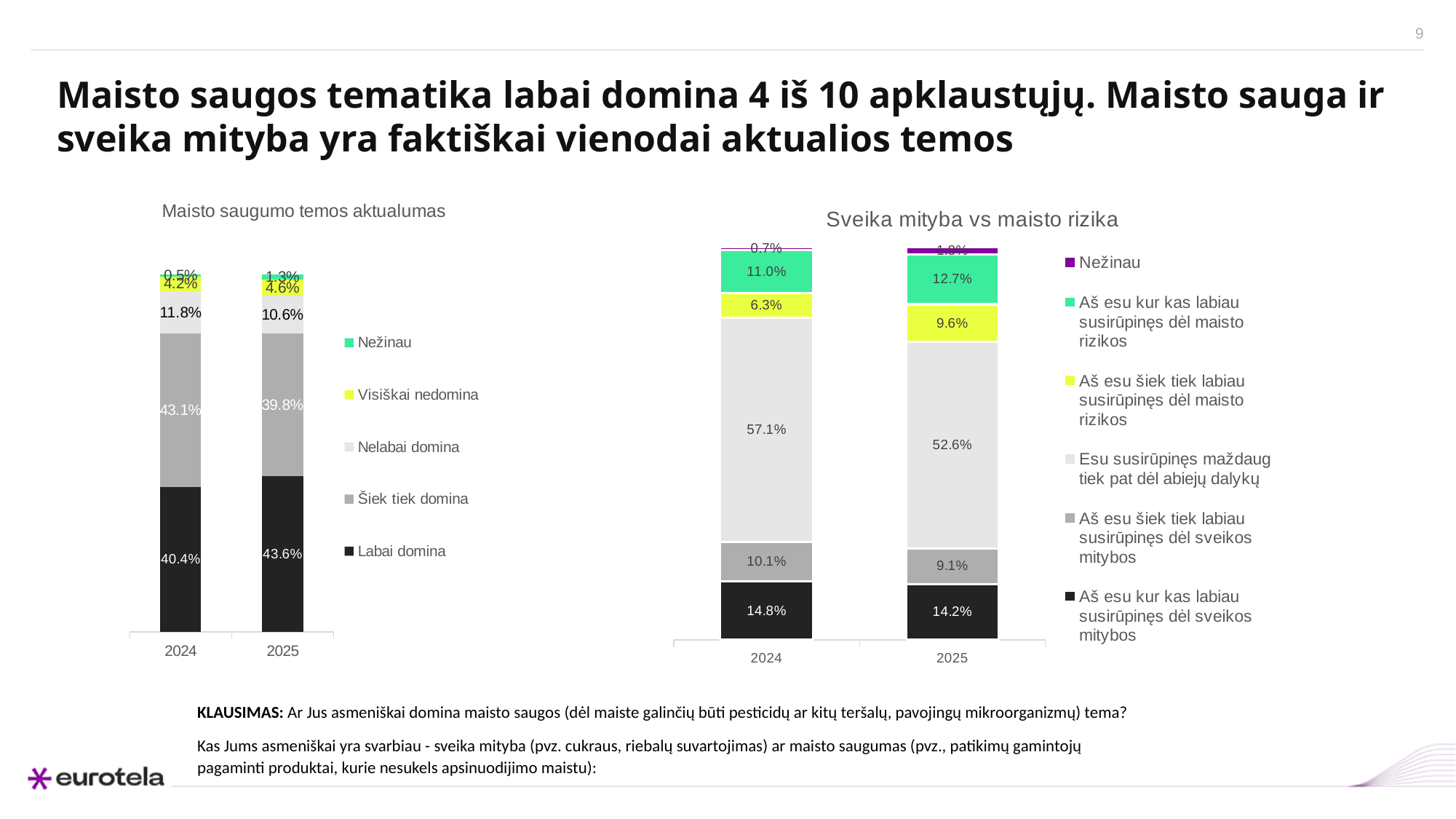
What kind of chart is the chart titled "Sveika mityba vs maisto rizika"? Stacked bar chart In the chart titled "Maisto saugumo temos aktualumas", how many series does the legend list? 5 In the chart titled "Sveika mityba vs maisto rizika", how many series does the legend list? 6 In the chart titled "Maisto saugumo temos aktualumas", what is the value for "Labai domina" in 2024? 40.4% In the chart titled "Maisto saugumo temos aktualumas", which is larger in 2024: "Labai domina" or "Šiek tiek domina"? Šiek tiek domina In the chart titled "Maisto saugumo temos aktualumas", what is the value for "Nelabai domina" in 2024? 11.8% In the chart titled "Sveika mityba vs maisto rizika", what is the value for "Aš esu kur kas labiau susirūpinęs dėl maisto rizikos" in 2025? 12.7% In the chart titled "Maisto saugumo temos aktualumas", what is the value for "Šiek tiek domina" in 2025? 39.8% In the chart titled "Sveika mityba vs maisto rizika", what is the value for "Aš esu kur kas labiau susirūpinęs dėl sveikos mitybos" in 2024? 14.8% In the chart titled "Sveika mityba vs maisto rizika", what is the value for "Esu susirūpinęs maždaug tiek pat dėl abiejų dalykų" in 2024? 57.1% In the chart titled "Maisto saugumo temos aktualumas", by how many percentage points did "Labai domina" change from 2024 to 2025? 3.2 percentage points In the chart titled "Sveika mityba vs maisto rizika", which segment is the largest in 2025? Esu susirūpinęs maždaug tiek pat dėl abiejų dalykų